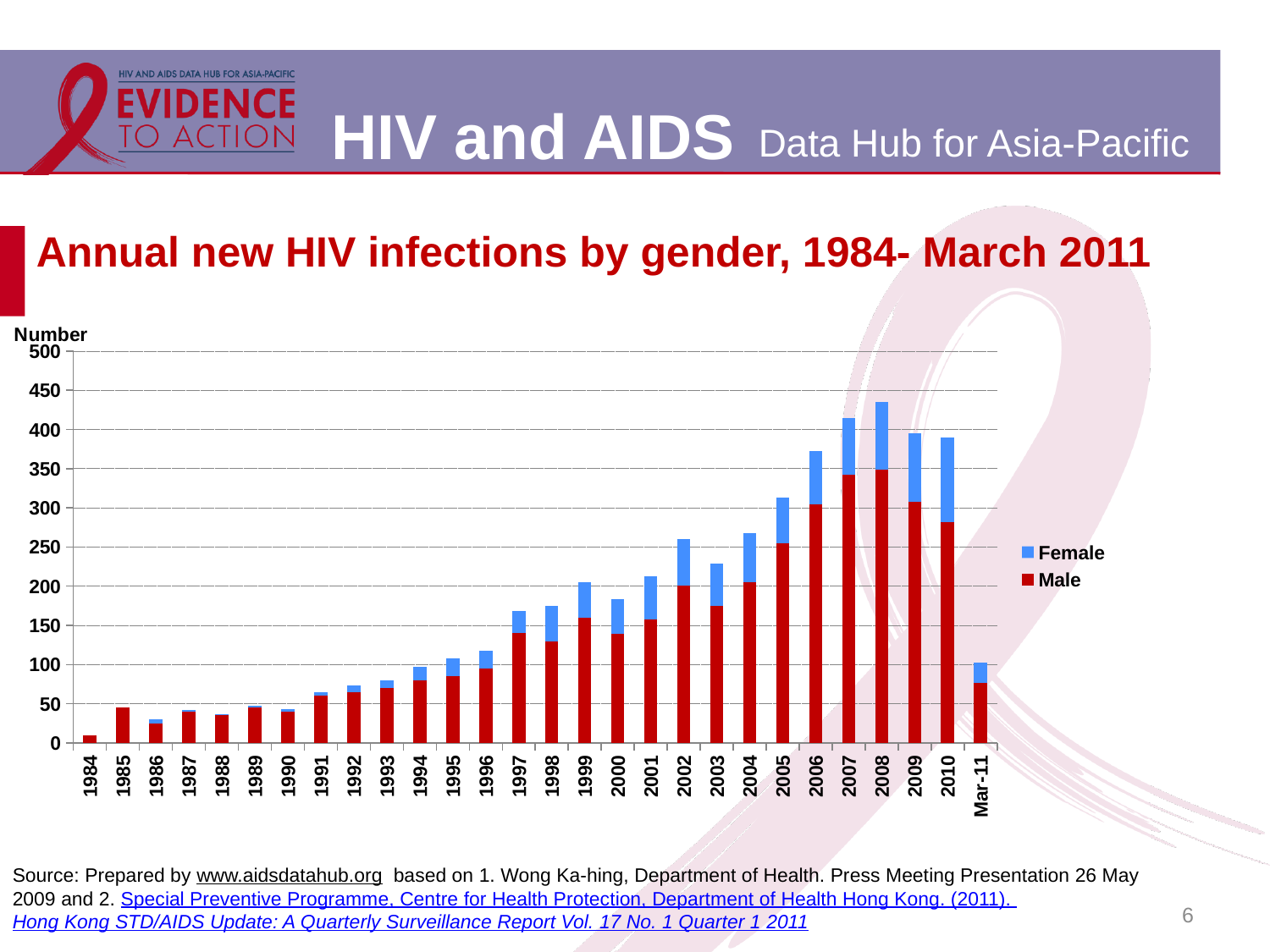
How many categories are shown along the x axis? 28 Which year has the highest total number of new HIV infections? 2008 Which has a larger total, 2006 or 2005? 2006 Do the total annual new HIV infections generally rise or fall from 1984 to 2008? rise Which colour represents the Female series in the legend? Blue What kind of chart is shown on the slide? Stacked bar chart Is the total value for 2008 greater or less than 400? greater How many series does the legend list? 2 Which year has the lowest total number of new HIV infections? 1984 Is the Male value for 2007 greater or less than 300? greater Is the total value for 2006 greater or less than 400? less